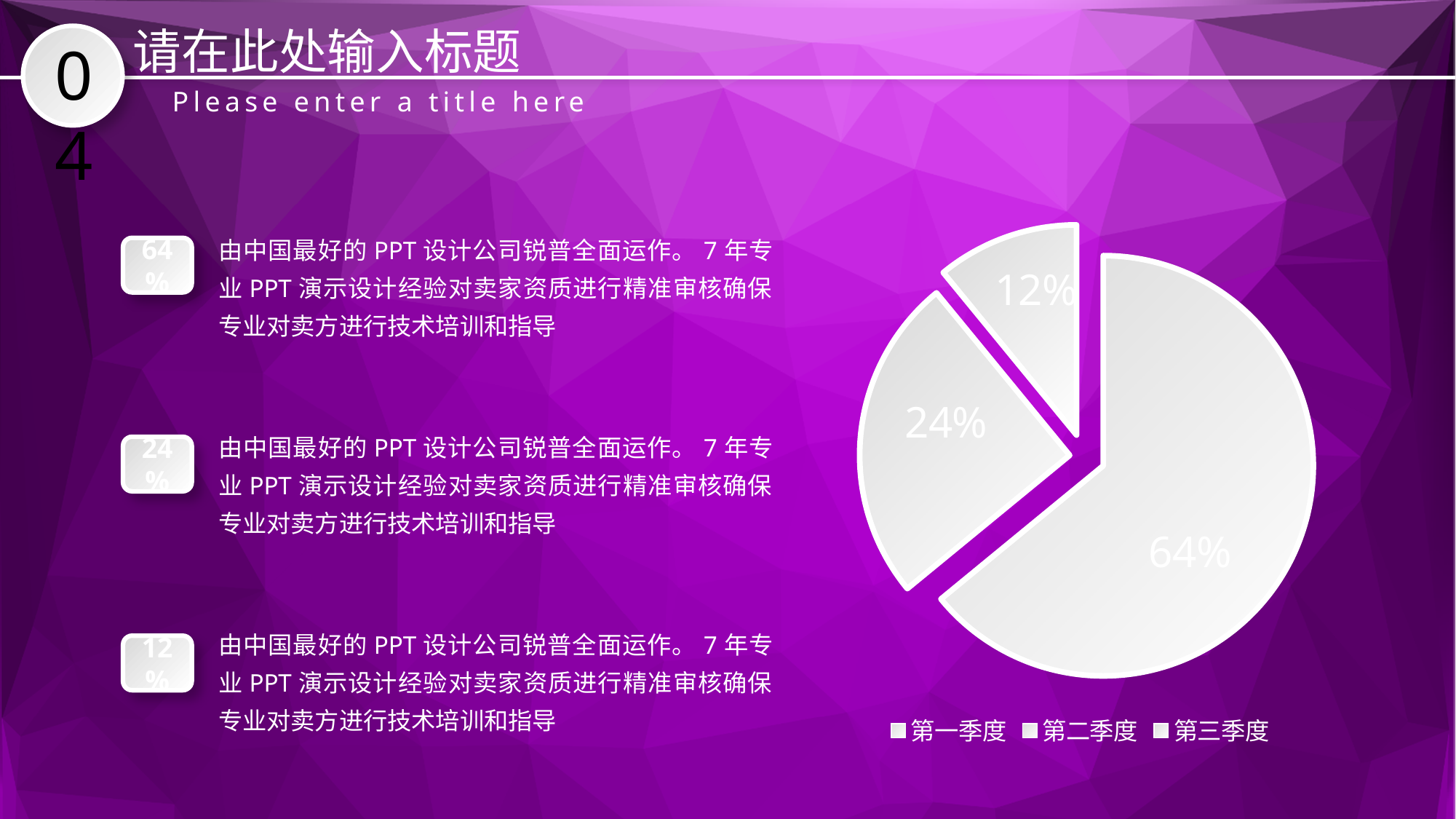
What do the three slices of the pie chart add up to? 100% What is the difference between the 64% slice and the 24% slice in the pie chart? 40% What is the difference between the largest and smallest slices in the pie chart? 52% Which is larger in the pie chart, the 24% slice or the 12% slice? 24% What is the value of the largest slice in the pie chart? 64% Is the largest slice of the pie chart greater or less than 50%? greater What are the three legend entries of the pie chart? 第一季度, 第二季度, 第三季度 What colour are the slices of the pie chart? grey/white What kind of chart is shown on the slide? pie chart What is the value of the smallest slice in the pie chart? 12% How many entries does the legend of the pie chart list? 3 How many slices does the pie chart have? 3